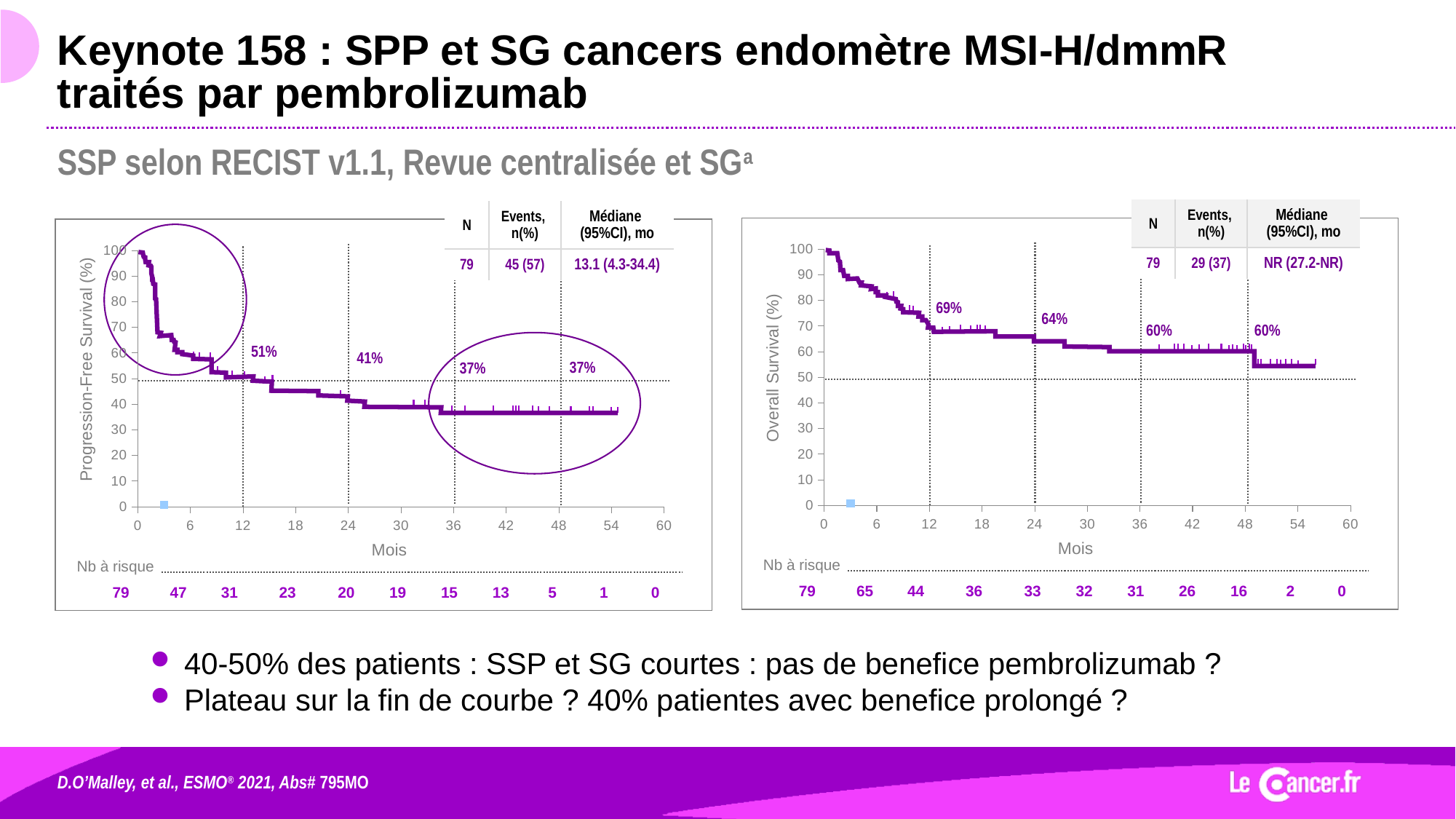
On the left Progression-Free Survival chart, which labelled landmark rate is higher: 12 months or 36 months? 12 months On the right Overall Survival chart, what is the survival rate labelled at 48 months? 60% Does the curve on the left Progression-Free Survival chart rise or fall as months increase? fall On the right Overall Survival chart, how many patients are at risk at 48 months? 16 On the left Progression-Free Survival chart, how many patients are at risk at 24 months? 20 On the right Overall Survival chart, is the curve at 54 months greater or less than 50%? greater On the right Overall Survival chart, how many events, n(%), are reported in the table? 29 (37) On the left Progression-Free Survival chart, what is the survival rate labelled at 12 months? 51% On the left Progression-Free Survival chart, what is the survival rate labelled at 24 months? 41% On the right Overall Survival chart, what is the survival rate labelled at 12 months? 69% What is the difference between the 12-month rate on the Overall Survival chart (69%) and the 12-month rate on the Progression-Free Survival chart (51%)? 18% On the left Progression-Free Survival chart, what is the median (95% CI) in months shown in the table? 13.1 (4.3-34.4)